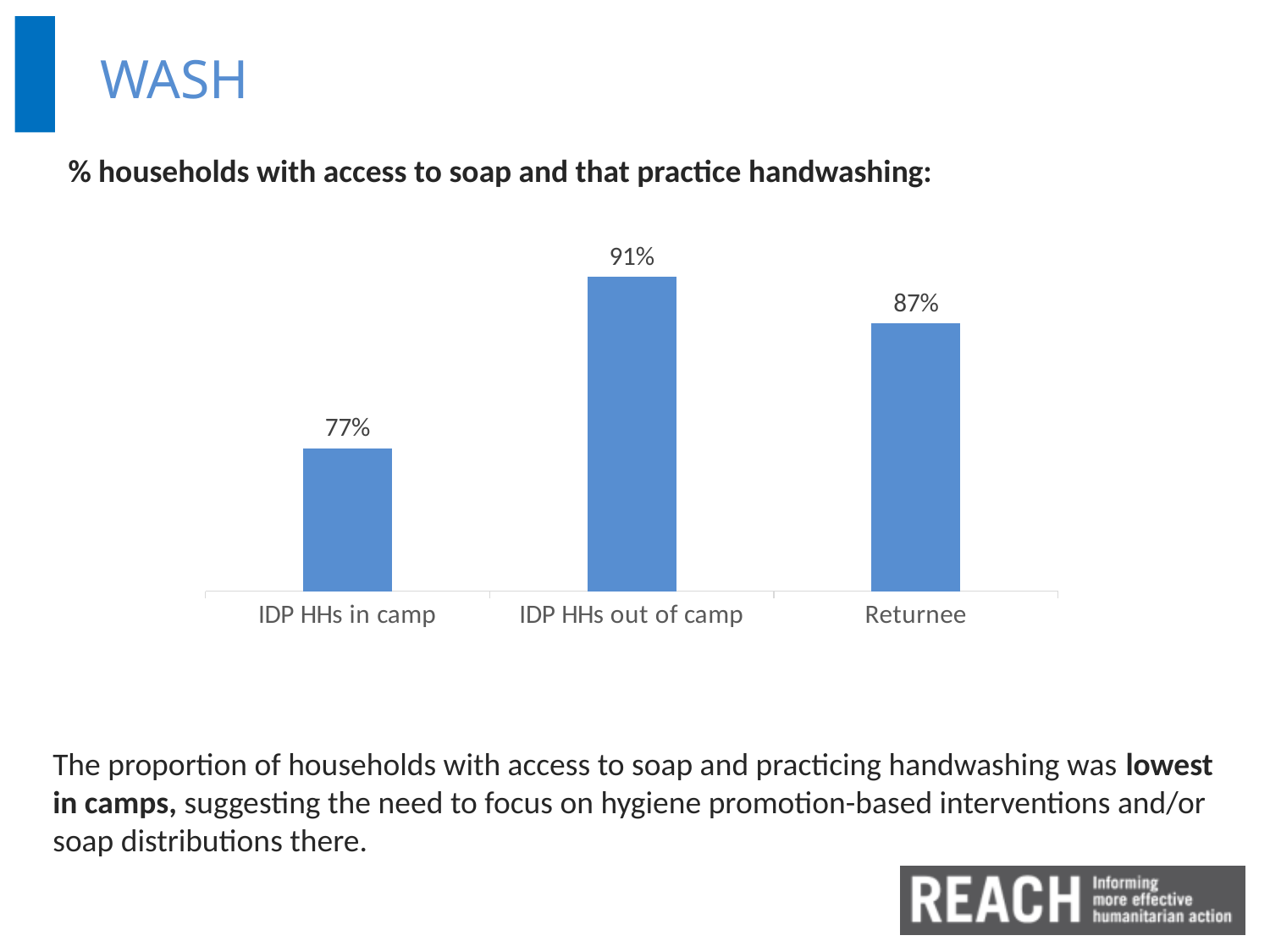
What type of chart is shown on the slide? Bar chart What is the difference between the Returnee value and the IDP HHs in camp value? 10 percentage points What is the title of the chart? % households with access to soap and that practice handwashing: What percentage of IDP HHs in camp have access to soap and practice handwashing? 77% What colour are the bars in the chart? Blue Which is larger, the value for Returnee or the value for IDP HHs out of camp? IDP HHs out of camp What is the value for IDP HHs out of camp? 91% Which category has the lowest percentage? IDP HHs in camp Which category has the highest percentage of households with access to soap and practicing handwashing? IDP HHs out of camp What is the value for Returnee households? 87% What is the difference in percentage points between IDP HHs out of camp and IDP HHs in camp? 14 percentage points How many categories are shown in the chart? 3